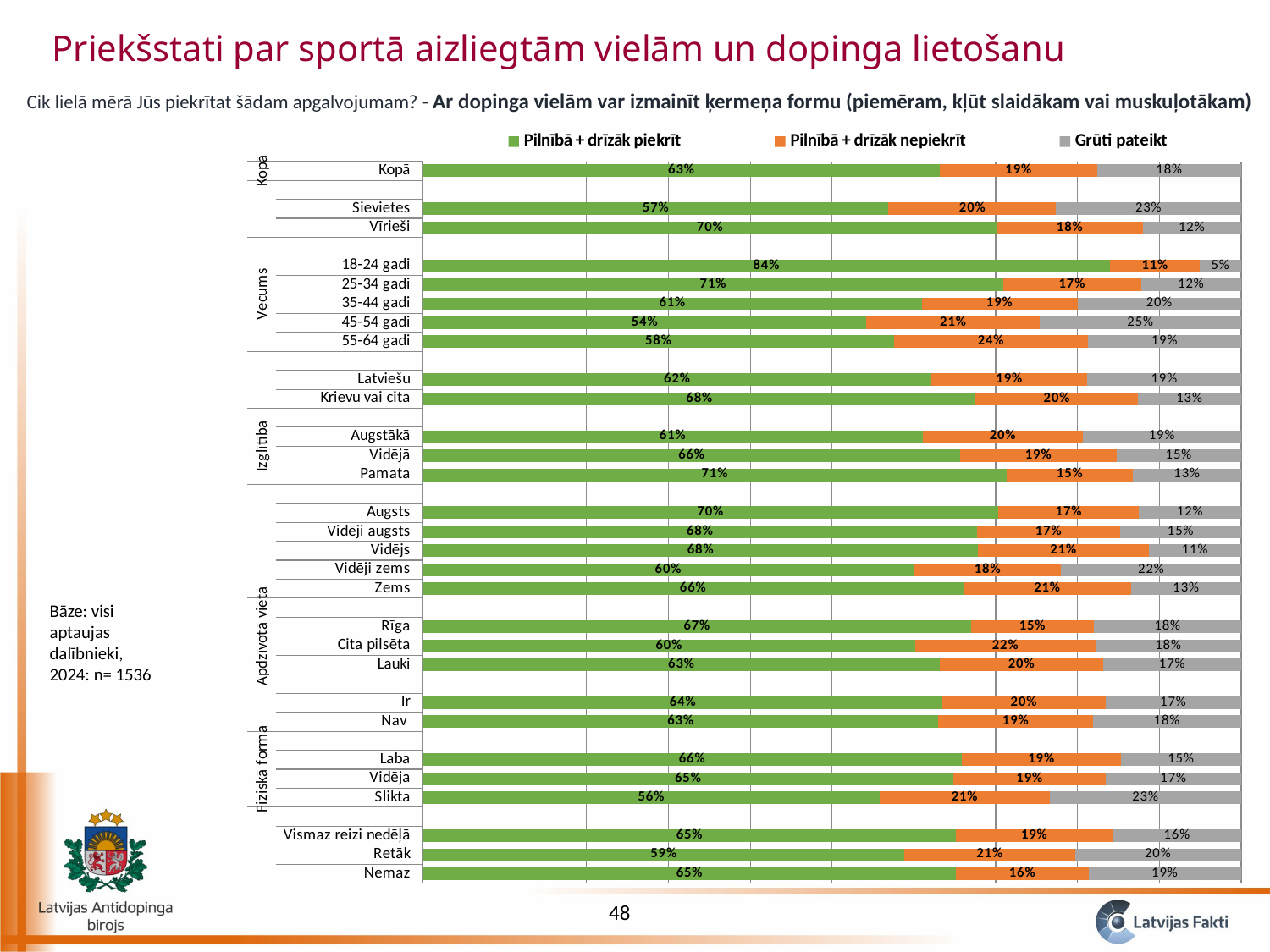
What is the "Pilnībā + drīzāk piekrīt" value for Kopā? 63% What is the "Pilnībā + drīzāk nepiekrīt" value for 55-64 gadi? 24% What is the total of the three segments for Krievu vai cita? 101% Which has a larger "Grūti pateikt" value, Slikta or Laba? Slikta How many series does the legend list? 3 What is the difference between the "Pilnībā + drīzāk piekrīt" values for Vīrieši and Sievietes? 13 percentage points Which category has the lowest "Pilnībā + drīzāk piekrīt" value? 45-54 gadi Which colour represents the "Grūti pateikt" series? Grey What is the "Grūti pateikt" value for 45-54 gadi? 25% What kind of chart is shown on the slide? Stacked bar chart Which category has the highest "Pilnībā + drīzāk piekrīt" value? 18-24 gadi How many categories are plotted in the chart? 29